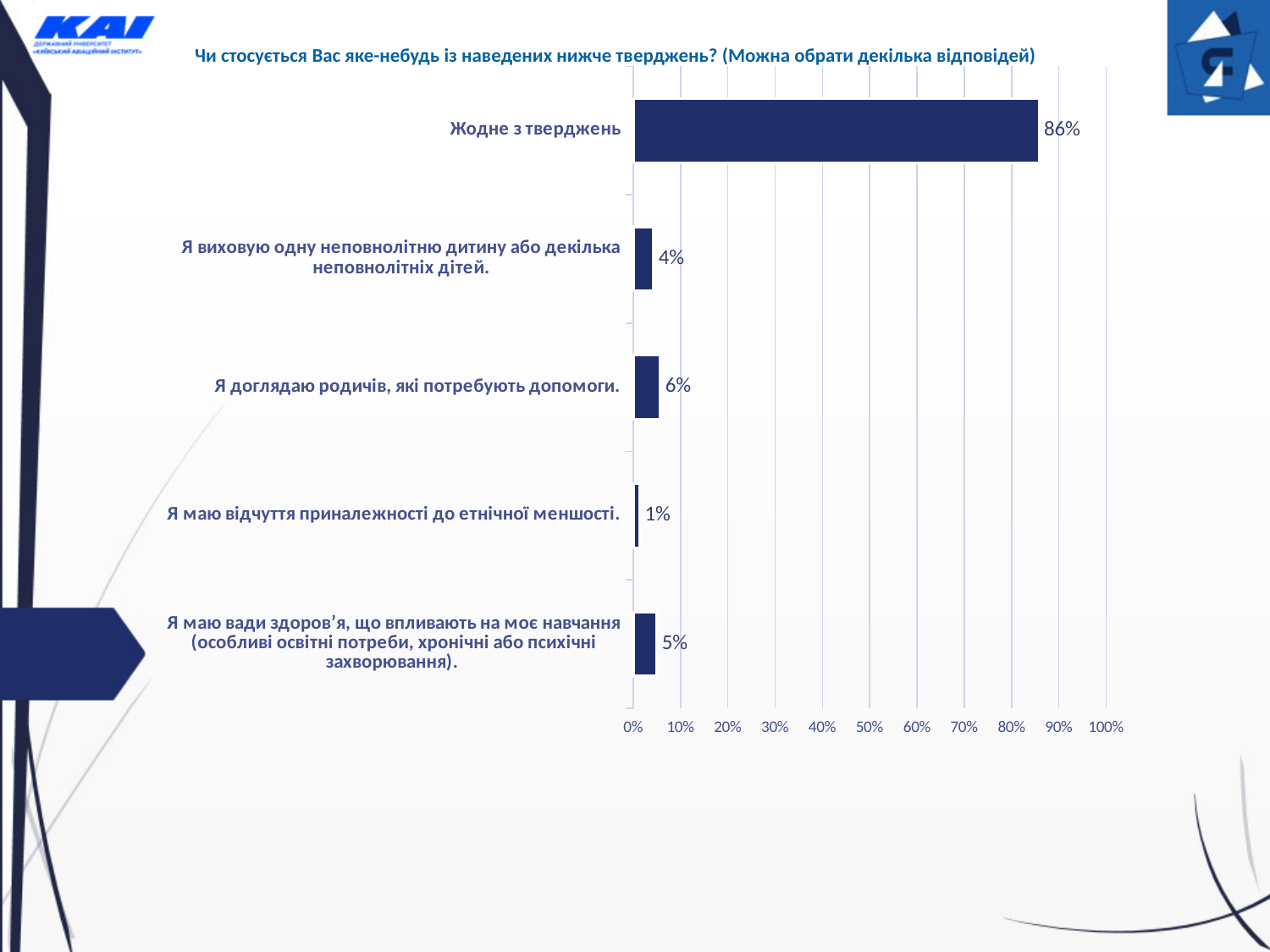
What is the difference between the value for "Жодне з тверджень" and the value for "Я доглядаю родичів, які потребують допомоги."? 80% Which category has the highest value? Жодне з тверджень What is the value for "Жодне з тверджень"? 86% What is the value for "Я маю відчуття приналежності до етнічної меншості."? 1% What is the value for "Я доглядаю родичів, які потребують допомоги."? 6% Which category has the lowest value? Я маю відчуття приналежності до етнічної меншості. How many categories are shown in the chart? 5 What kind of chart is shown on the slide? bar chart Is the value for "Жодне з тверджень" greater or less than 80%? greater What is the value for "Я виховую одну неповнолітню дитину або декілька неповнолітніх дітей."? 4% Which is larger: the value for "Я доглядаю родичів, які потребують допомоги." or the value for "Я виховую одну неповнолітню дитину або декілька неповнолітніх дітей."? Я доглядаю родичів, які потребують допомоги. What is the title of the chart? Чи стосується Вас яке-небудь із наведених нижче тверджень? (Можна обрати декілька відповідей)